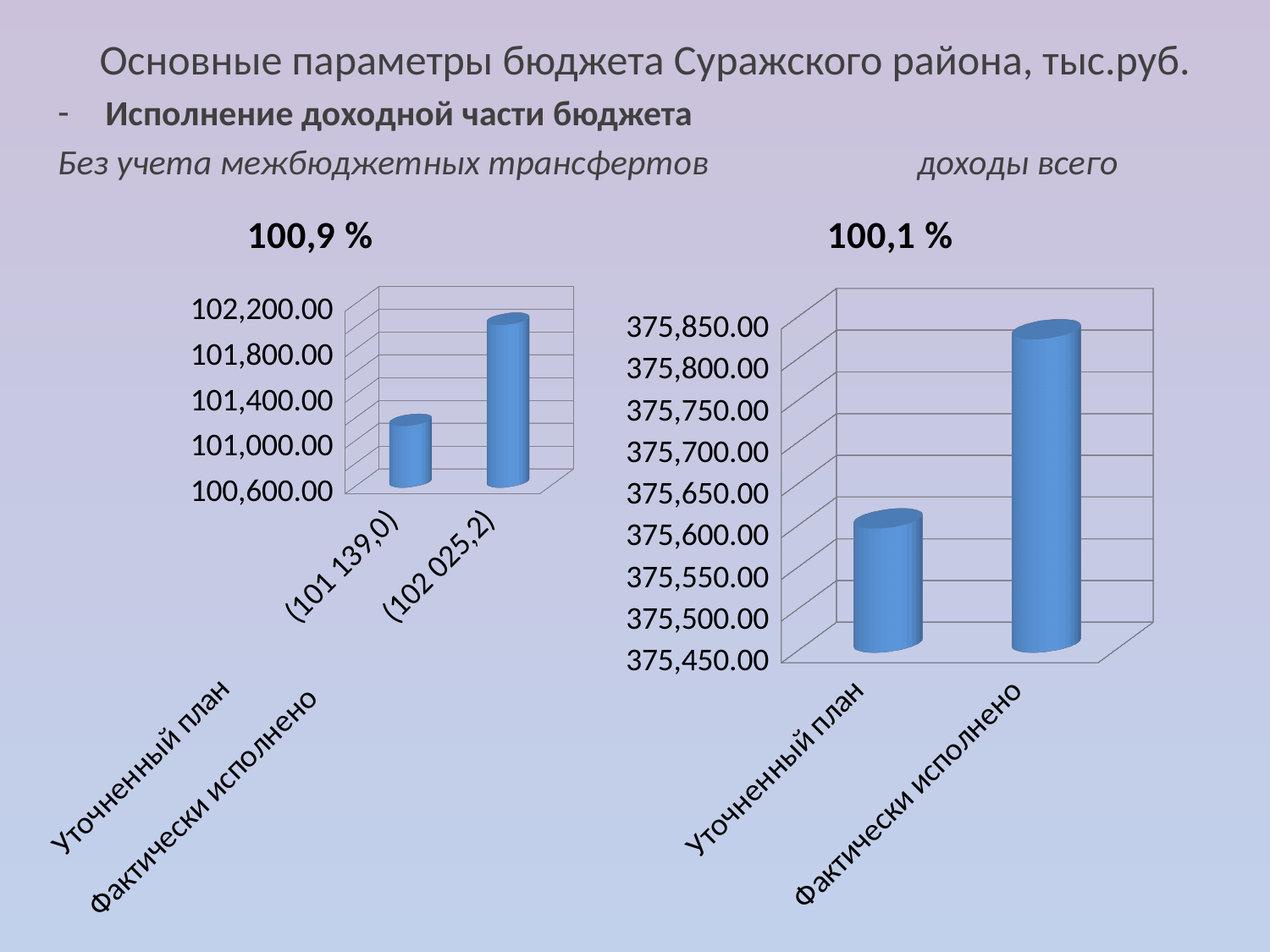
On the right chart (доходы всего), which category has the lower value? Уточненный план What execution percentage is shown above the right chart (доходы всего)? 100,1 % On the left chart (Без учета межбюджетных трансфертов), what is the difference between Фактически исполнено and Уточненный план? 886,2 On the left chart (Без учета межбюджетных трансфертов), what is the value for Фактически исполнено? 102 025,2 On the right chart (доходы всего), which is larger: Уточненный план or Фактически исполнено? Фактически исполнено On the right chart (доходы всего), is the value for Фактически исполнено greater or less than 375,750.00? greater What type of chart is the left chart (Без учета межбюджетных трансфертов)? bar chart On the left chart (Без учета межбюджетных трансфертов), what is the value for Уточненный план? 101 139,0 What execution percentage is shown above the left chart (Без учета межбюджетных трансфертов)? 100,9 % On the left chart (Без учета межбюджетных трансфертов), which category has the higher value? Фактически исполнено On the right chart (доходы всего), is the value for Уточненный план greater or less than 375,700.00? less How many categories does the right chart (доходы всего) show? 2